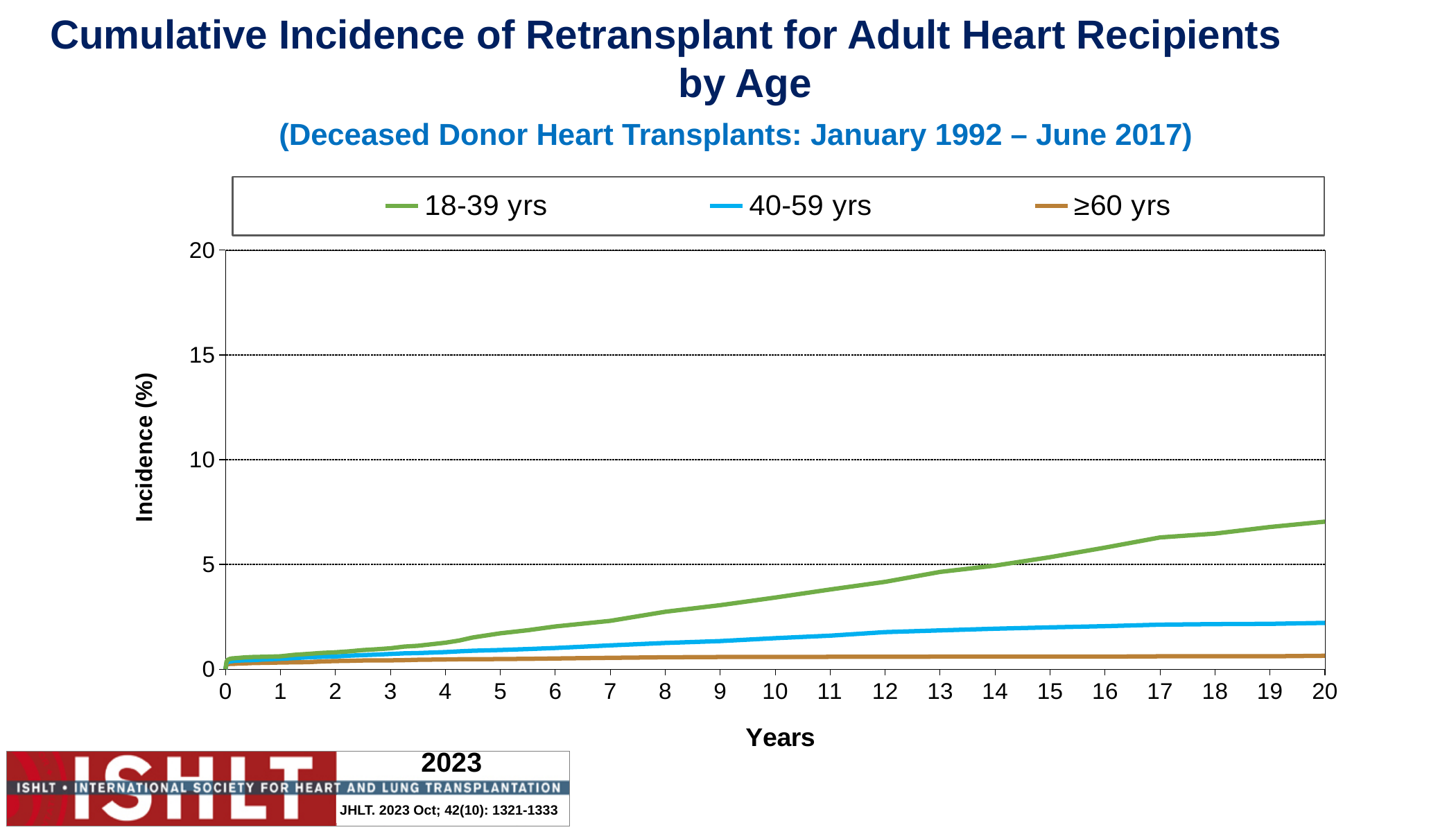
What colour is the line for the 40-59 yrs series? Blue Does the 18-39 yrs line rise or fall as years increase? Rise Is the value for 40-59 yrs at 20 years greater or less than 5? less What kind of chart is shown on the slide? Line chart Which age group has the lowest cumulative incidence of retransplant at 20 years? ≥60 yrs What is the label of the y axis? Incidence (%) Is the value for 18-39 yrs at 20 years greater or less than 5? greater Is the value for 18-39 yrs at 20 years greater or less than 10? less Which age group has the highest cumulative incidence of retransplant at 20 years? 18-39 yrs At 20 years, which is larger: the value for 40-59 yrs or the value for ≥60 yrs? 40-59 yrs How many series does the legend list? 3